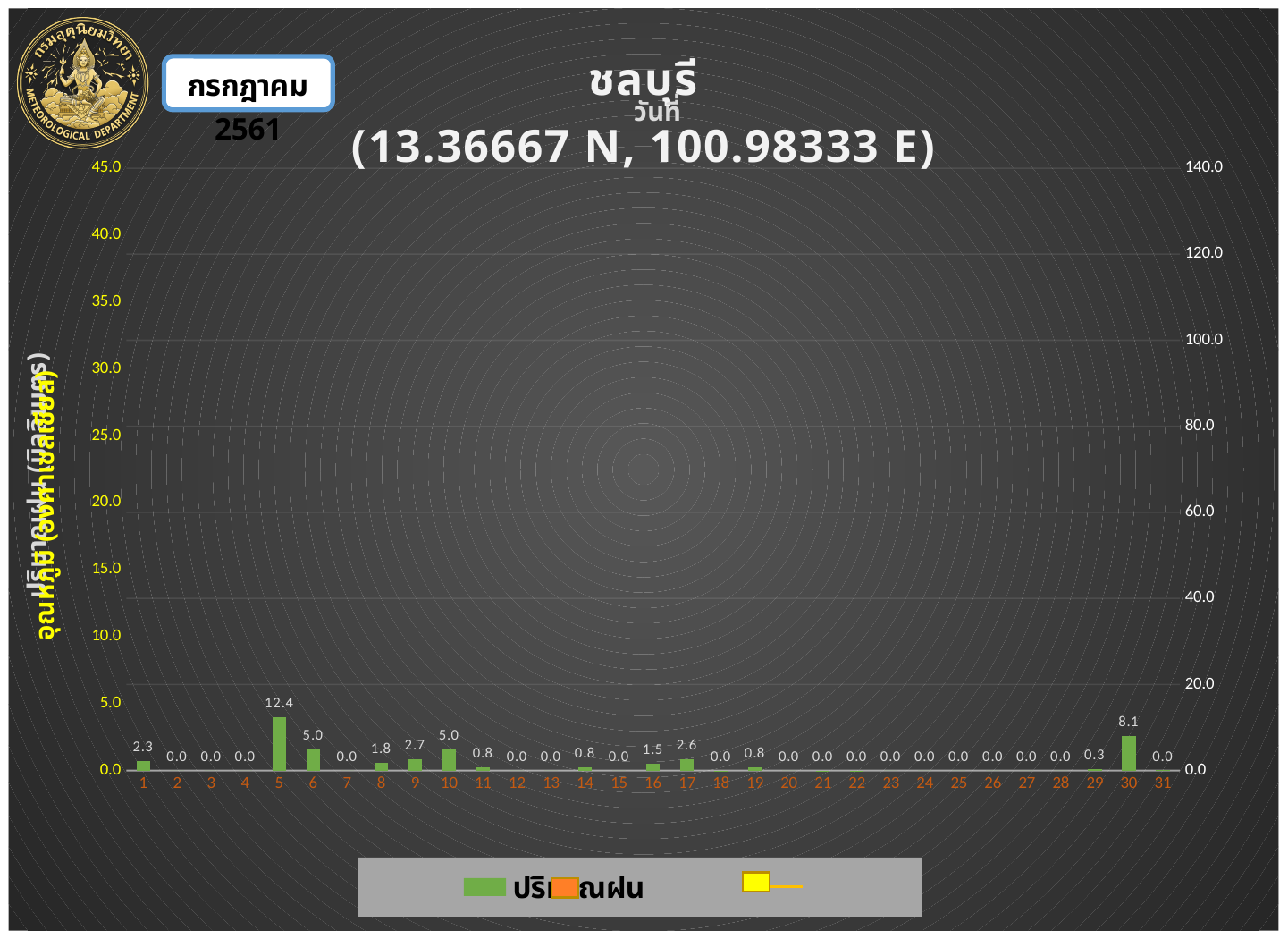
What colour are the rainfall bars? green What is the rainfall value shown for day 5? 12.4 What is the difference between the rainfall values for day 5 and day 30? 4.3 What coordinates are given in the chart title? 13.36667 N, 100.98333 E Which day has the highest rainfall value? 5 What kind of chart is this? bar chart What is the rainfall value shown for day 10? 5.0 What is the rainfall value shown for day 17? 2.6 Which has the larger rainfall value, day 6 or day 9? day 6 How many days are shown on the x axis? 31 Which has the larger rainfall value, day 1 or day 8? day 1 What is the rainfall value shown for day 30? 8.1